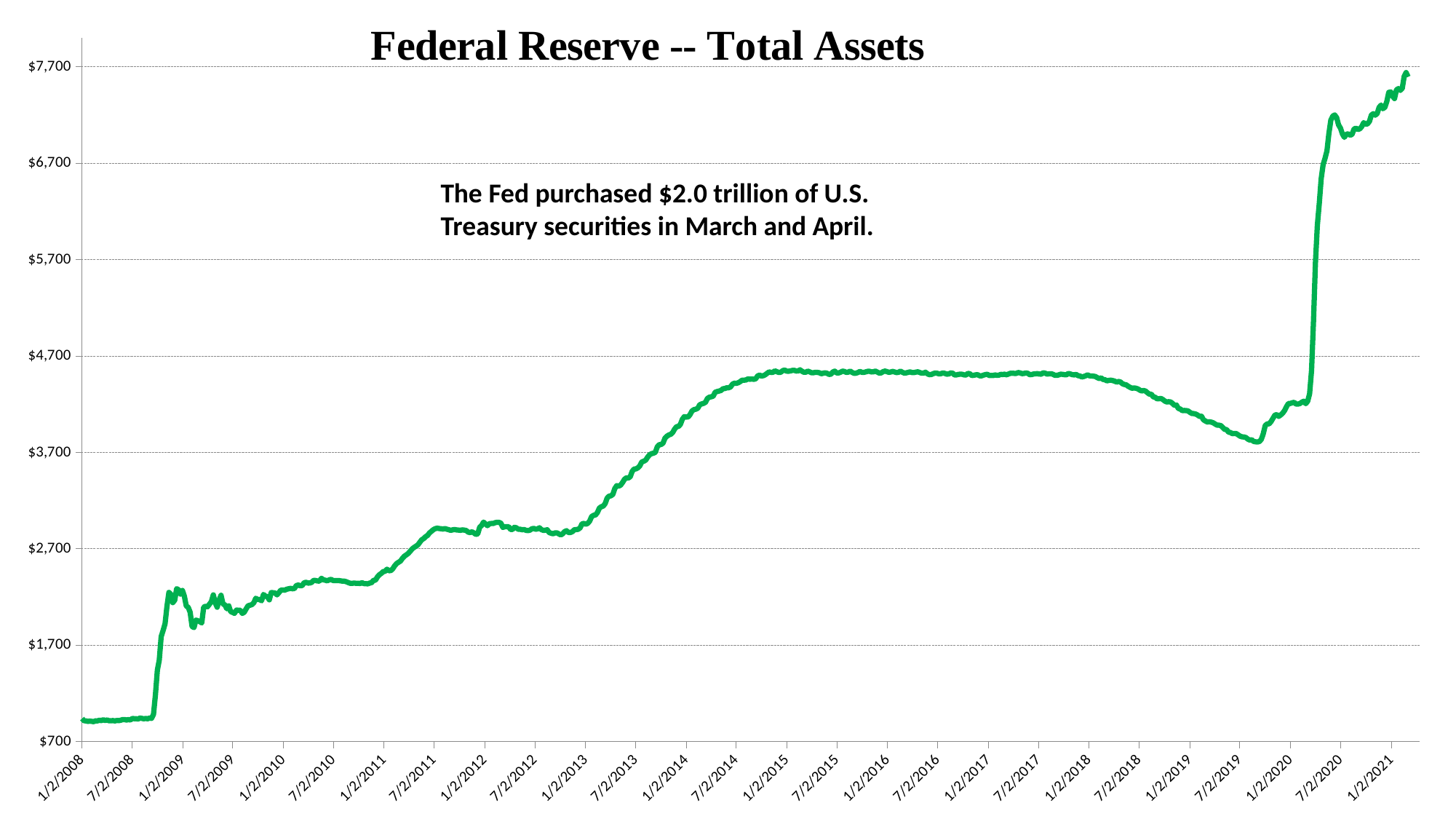
Is the value at 1/2/2020 greater or less than $4,700? less Is the value at 1/2/2015 greater or less than $3,700? greater What kind of chart is shown on the slide? line chart Does the line rise or fall between 1/2/2018 and 7/2/2019? fall What is the title of the chart? Federal Reserve -- Total Assets How many date labels are shown on the x axis? 27 Is the value at 1/2/2008 greater or less than $1,700? less Which is larger, the value at 1/2/2021 or the value at 1/2/2008? 1/2/2021 What colour is the line plotted on the chart? green Overall, does the line rise or fall from 1/2/2008 to 1/2/2021? rise